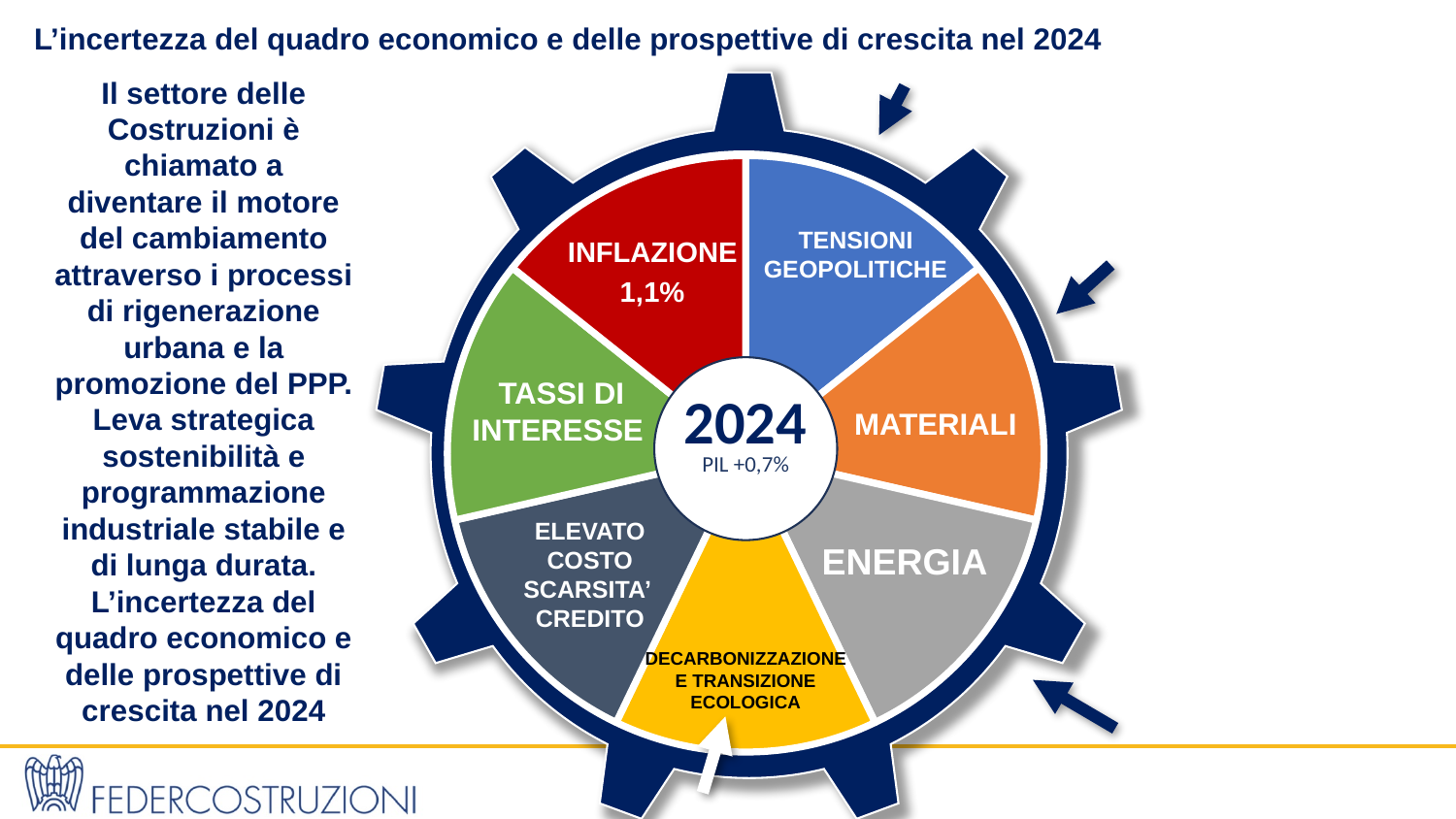
What PIL value is printed in the centre of the chart? PIL +0,7% What year is printed in the centre of the chart? 2024 What value is printed on the INFLAZIONE segment? 1,1% What colour is the ENERGIA segment? grey How many segments does the chart have? 7 Which segment of the chart has a percentage value printed on it? INFLAZIONE What kind of chart is shown on the slide? doughnut chart